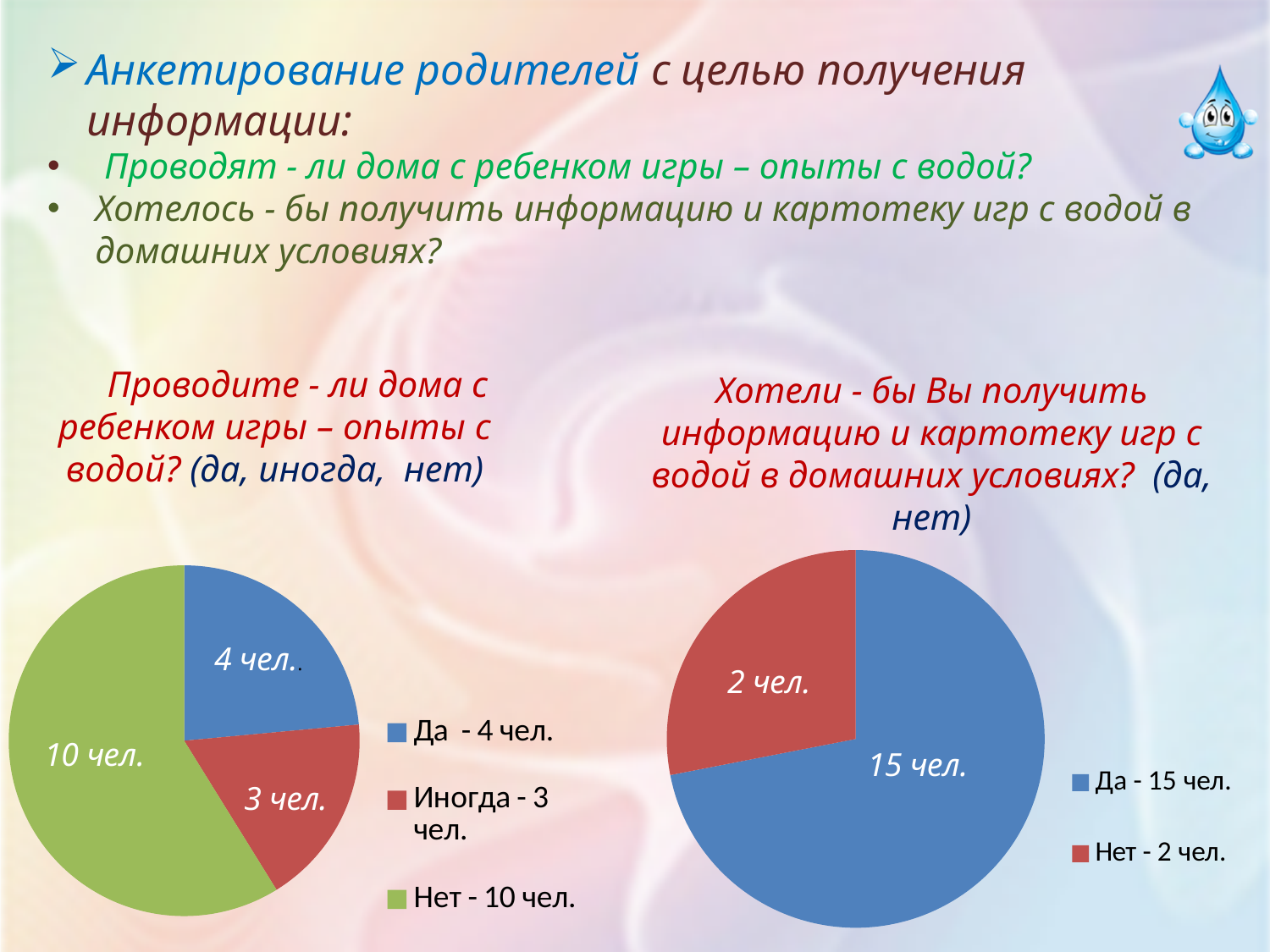
How many entries does the legend of the right pie chart list? 2 How many slices does the left pie chart have? 3 In the right pie chart, how many people answered "Нет"? 2 чел. In the left pie chart, how many people answered "Нет"? 10 чел. In the right pie chart, how many people answered "Да"? 15 чел. In the right pie chart, which is larger, "Да" or "Нет"? Да What kind of chart is the left chart on the slide? pie chart In the left pie chart, how many more people answered "Нет" than "Да"? 6 In the left pie chart, which answer has the smallest slice? Иногда In the left pie chart, how many people answered "Да"? 4 чел. In the left pie chart, which answer has the largest slice? Нет In the left pie chart, what colour is the "Нет" slice? green